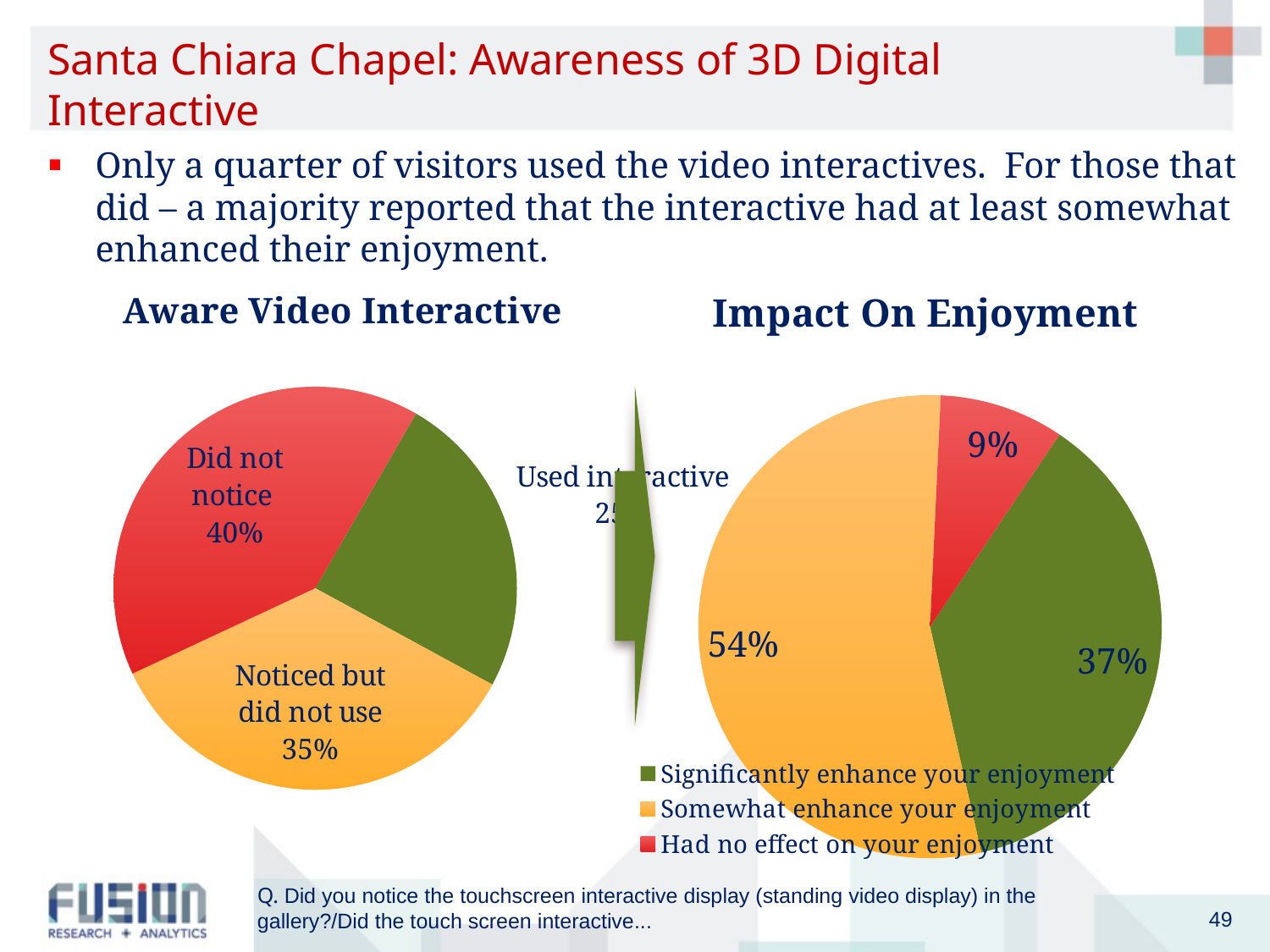
In the 'Aware Video Interactive' chart, which category has the largest share? Did not notice In the 'Aware Video Interactive' chart, what percentage of visitors noticed but did not use the interactive? 35% In the 'Impact On Enjoyment' chart, how many percentage points larger is 'Somewhat enhance your enjoyment' than 'Significantly enhance your enjoyment'? 17 percentage points In the 'Impact On Enjoyment' chart, how many entries does the legend list? 3 In the 'Impact On Enjoyment' chart, what percentage said the interactive significantly enhanced their enjoyment? 37% In the 'Aware Video Interactive' chart, how many slices does the pie have? 3 In the 'Aware Video Interactive' chart, what percentage of visitors did not notice the interactive? 40% In the 'Impact On Enjoyment' chart, what percentage said the interactive somewhat enhanced their enjoyment? 54% In the 'Aware Video Interactive' chart, how many percentage points larger is 'Did not notice' than 'Noticed but did not use'? 5 percentage points In the 'Impact On Enjoyment' chart, what percentage said the interactive had no effect on their enjoyment? 9% In the 'Aware Video Interactive' chart, what kind of chart is used? Pie chart In the 'Impact On Enjoyment' chart, which response has the smallest share? Had no effect on your enjoyment